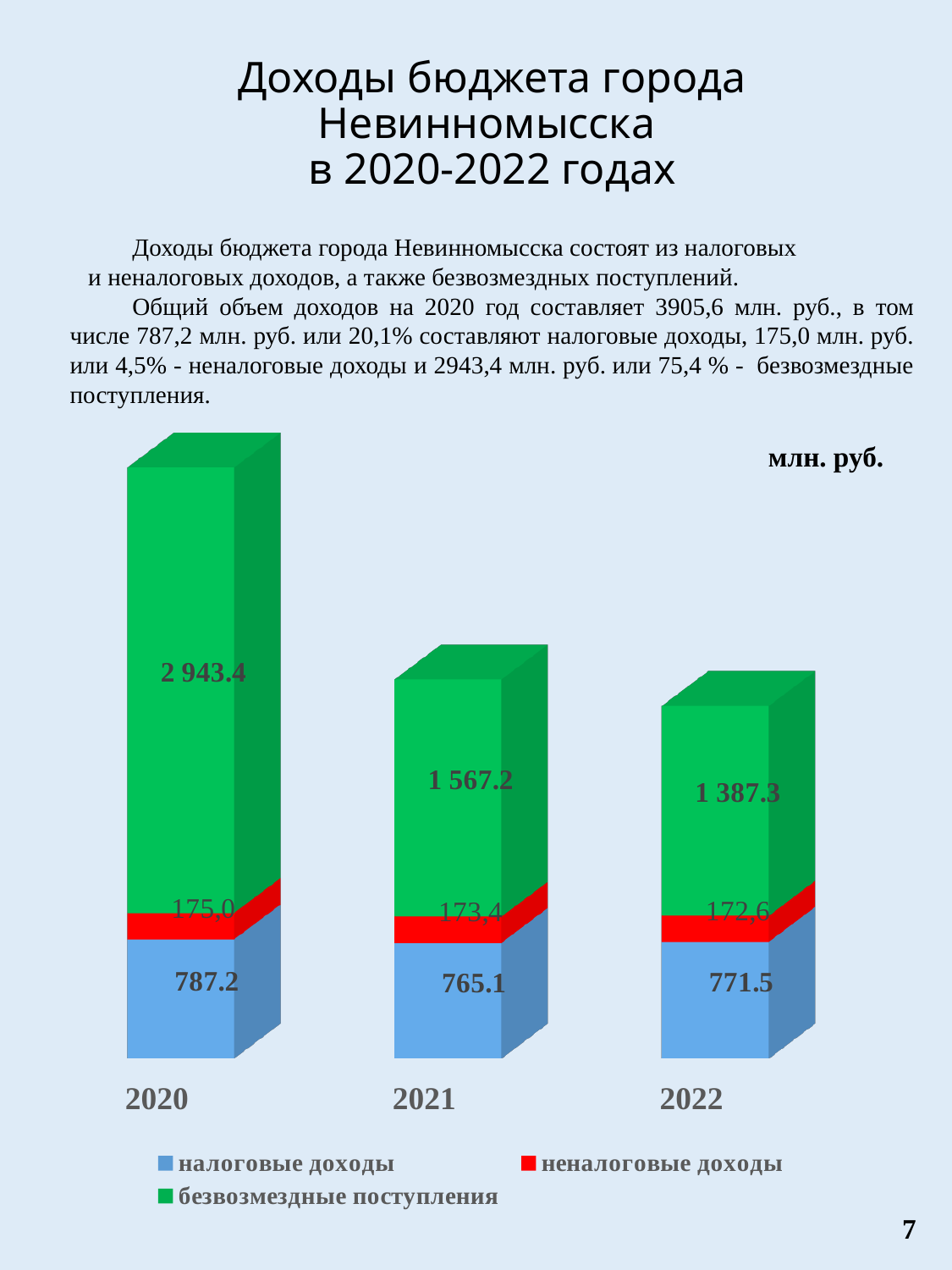
Which is larger: налоговые доходы in 2020 or in 2022? 2020 What kind of chart is shown on the slide? Stacked bar chart What is the value of неналоговые доходы for 2022? 172,6 How many years are shown on the x axis? 3 What is the value of налоговые доходы for 2021? 765.1 What is the value of безвозмездные поступления for 2022? 1 387.3 What is the total of the stacked bar for 2021? 2 505.7 What is the value of безвозмездные поступления for 2020? 2 943.4 How many series does the legend list? 3 What is the difference between безвозмездные поступления in 2020 and 2021? 1 376.2 In which year is налоговые доходы the lowest? 2021 In which year is безвозмездные поступления the highest? 2020